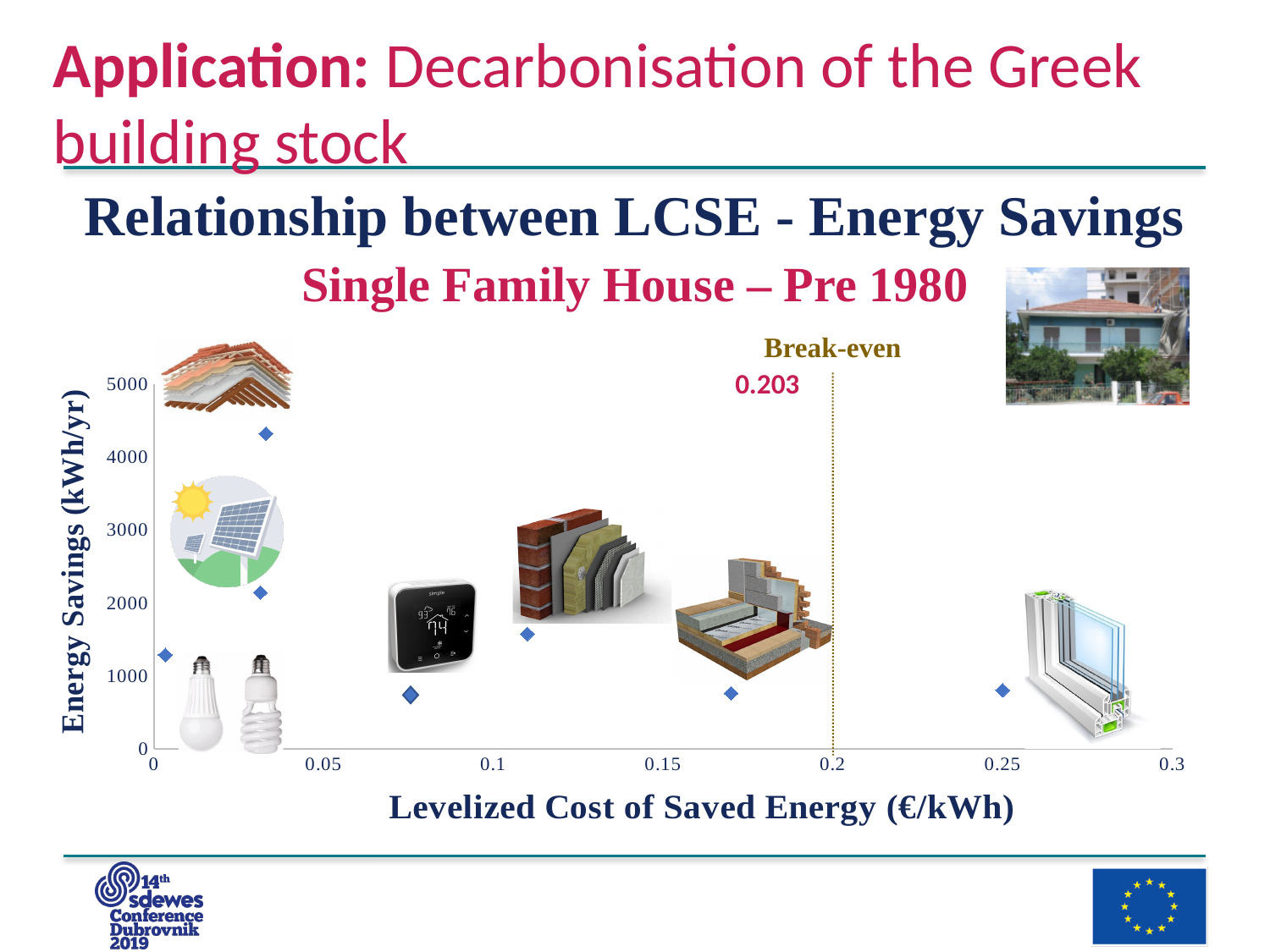
Is the Levelized Cost of Saved Energy for the highest point greater or less than 0.05? less Is the energy savings value of the highest point on the chart greater or less than 4000? greater Is the Levelized Cost of Saved Energy for the rightmost point greater or less than 0.2? greater What is the title of the chart's x axis? Levelized Cost of Saved Energy (€/kWh) What is the title of the chart's y axis? Energy Savings (kWh/yr) What break-even value of Levelized Cost of Saved Energy is marked on the chart? 0.203 What kind of chart is shown on the slide? scatter chart How many data points lie to the right of the break-even line? 1 How many data points have energy savings above 2000 kWh/yr? 2 What is the maximum value shown on the x axis? 0.3 How many data points are plotted on the chart? 7